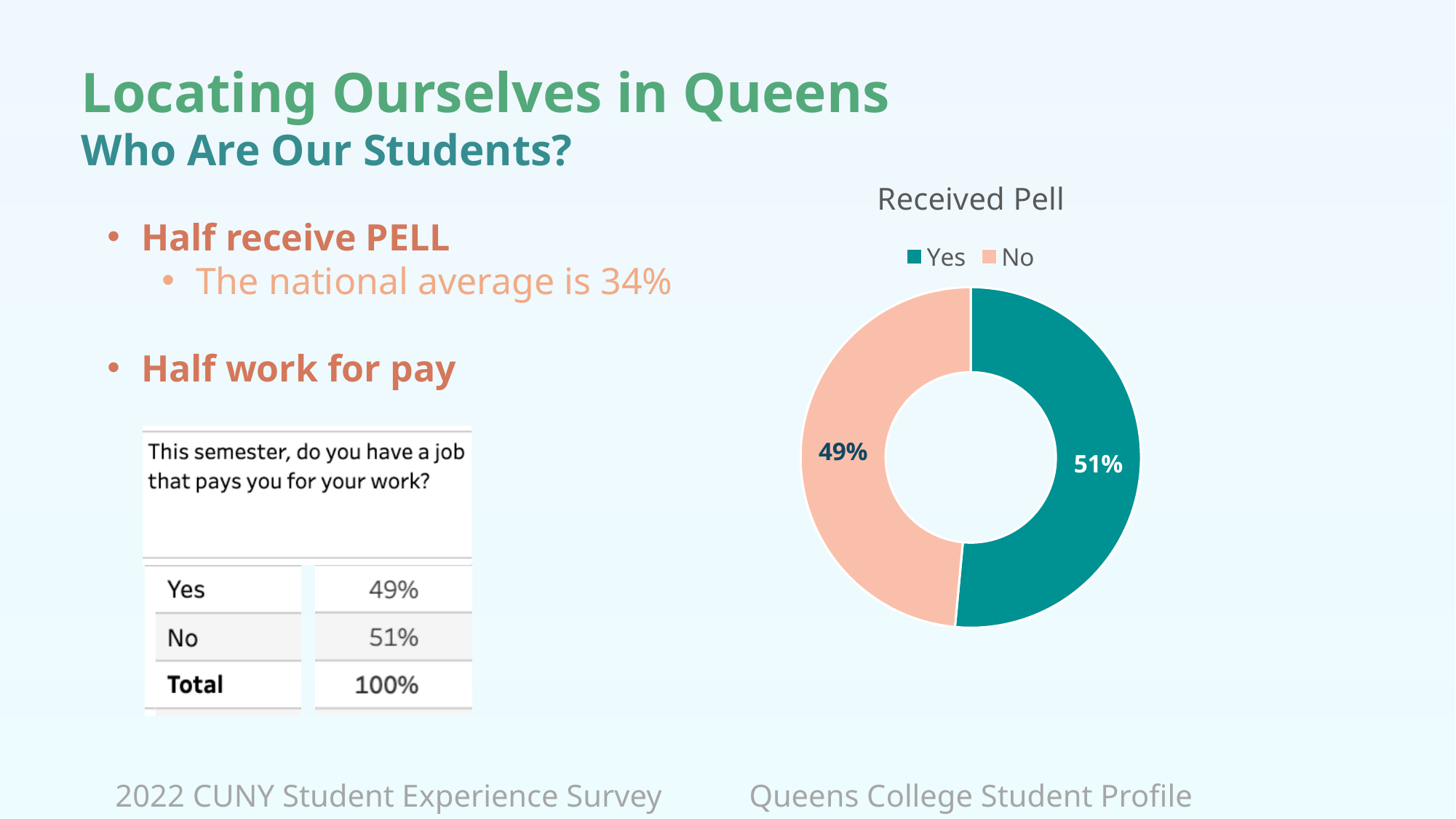
In the Received Pell chart, what is the value for the No slice? 49% In the Received Pell chart, is the Yes slice larger or smaller than the No slice? larger What kind of chart is the Received Pell chart? pie chart (donut) How many entries does the legend of the Received Pell chart list? 2 In the Received Pell chart, what is the difference in percentage points between the Yes and No slices? 2 percentage points In the Received Pell chart, what share of the pie does the Yes slice represent? 51% In the Received Pell chart, what percentage of students received Pell? 51% In the Received Pell chart, which colour represents the No category? light orange (peach) In the Received Pell chart, which category has the smaller share? No How many slices does the Received Pell chart have? 2 What is the title of the chart on the slide? Received Pell In the Received Pell chart, which category has the larger share? Yes